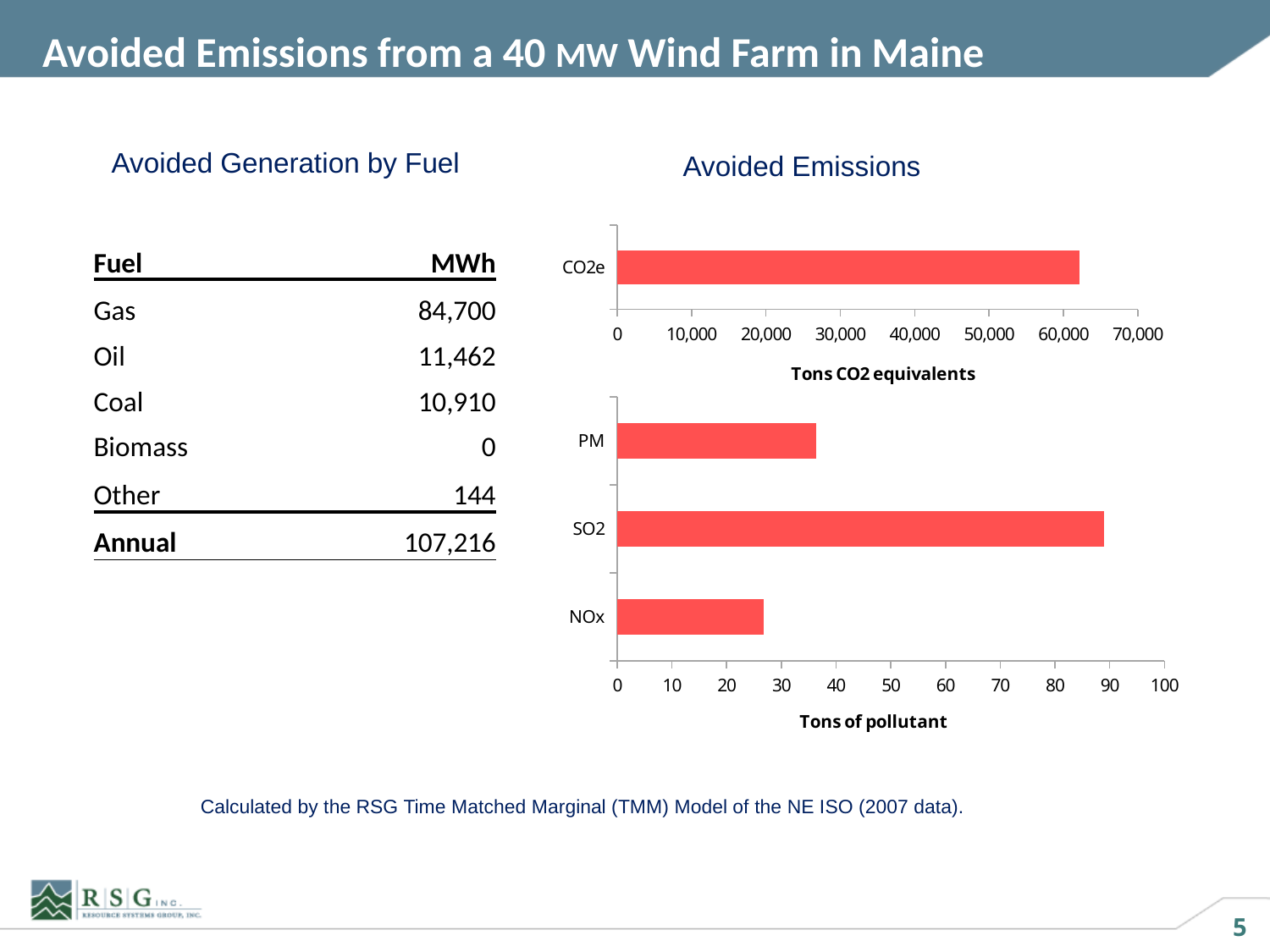
In the top chart (Tons CO2 equivalents), is the value for CO2e greater or less than 70,000? less What kind of chart is used for the Avoided Emissions charts? Bar chart In the bottom chart (Tons of pollutant), which pollutant has the lowest avoided emissions? NOx In the bottom chart (Tons of pollutant), which is larger, the value for PM or the value for NOx? PM In the top chart (Tons CO2 equivalents), is the value for CO2e greater or less than 60,000? greater In the bottom chart (Tons of pollutant), is the value for SO2 greater or less than 80? greater What colour are the bars in the Avoided Emissions charts? Red How many pollutant categories are shown in the bottom chart (Tons of pollutant)? 3 In the bottom chart (Tons of pollutant), which pollutant has the highest avoided emissions? SO2 What is the x-axis title of the top Avoided Emissions chart? Tons CO2 equivalents